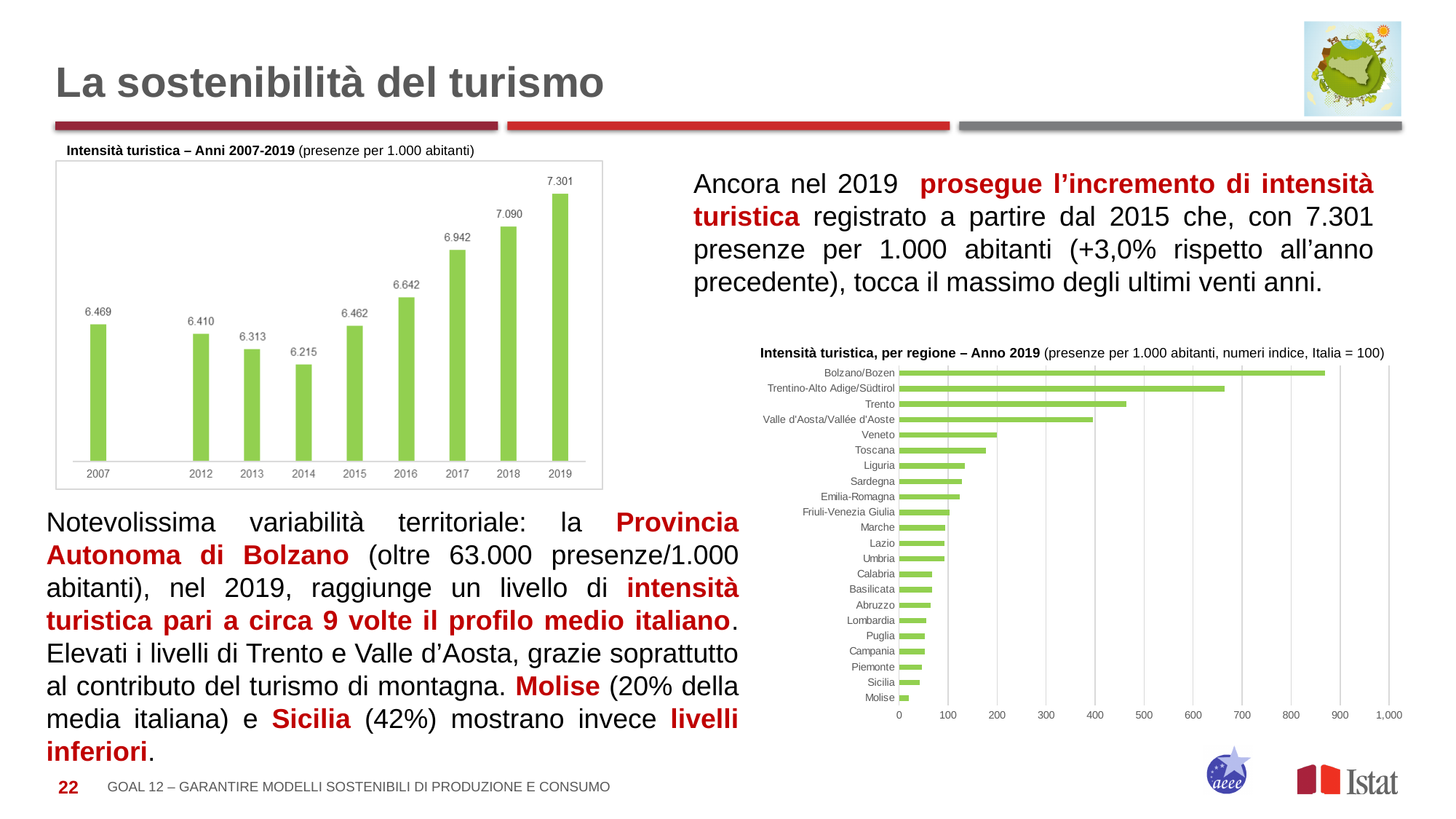
In the chart 'Intensità turistica – Anni 2007-2019', which year has the highest value? 2019 What kind of chart is 'Intensità turistica, per regione – Anno 2019'? bar chart In the chart 'Intensità turistica – Anni 2007-2019', how many years are shown? 9 In the chart 'Intensità turistica, per regione – Anno 2019', which region has the lowest value? Molise In the chart 'Intensità turistica – Anni 2007-2019', which year has the lowest value? 2014 In the chart 'Intensità turistica – Anni 2007-2019', what is the value for 2014? 6.215 In the chart 'Intensità turistica – Anni 2007-2019', which is larger, the value for 2007 or the value for 2012? 2007 In the chart 'Intensità turistica, per regione – Anno 2019', which region has the highest value? Bolzano/Bozen In the chart 'Intensità turistica – Anni 2007-2019', do the values rise or fall from 2015 to 2019? rise In the chart 'Intensità turistica, per regione – Anno 2019', is the value for Bolzano/Bozen greater or less than 800? greater In the chart 'Intensità turistica, per regione – Anno 2019', is the value for Veneto greater or less than 300? less In the chart 'Intensità turistica – Anni 2007-2019', what is the value for 2019? 7.301